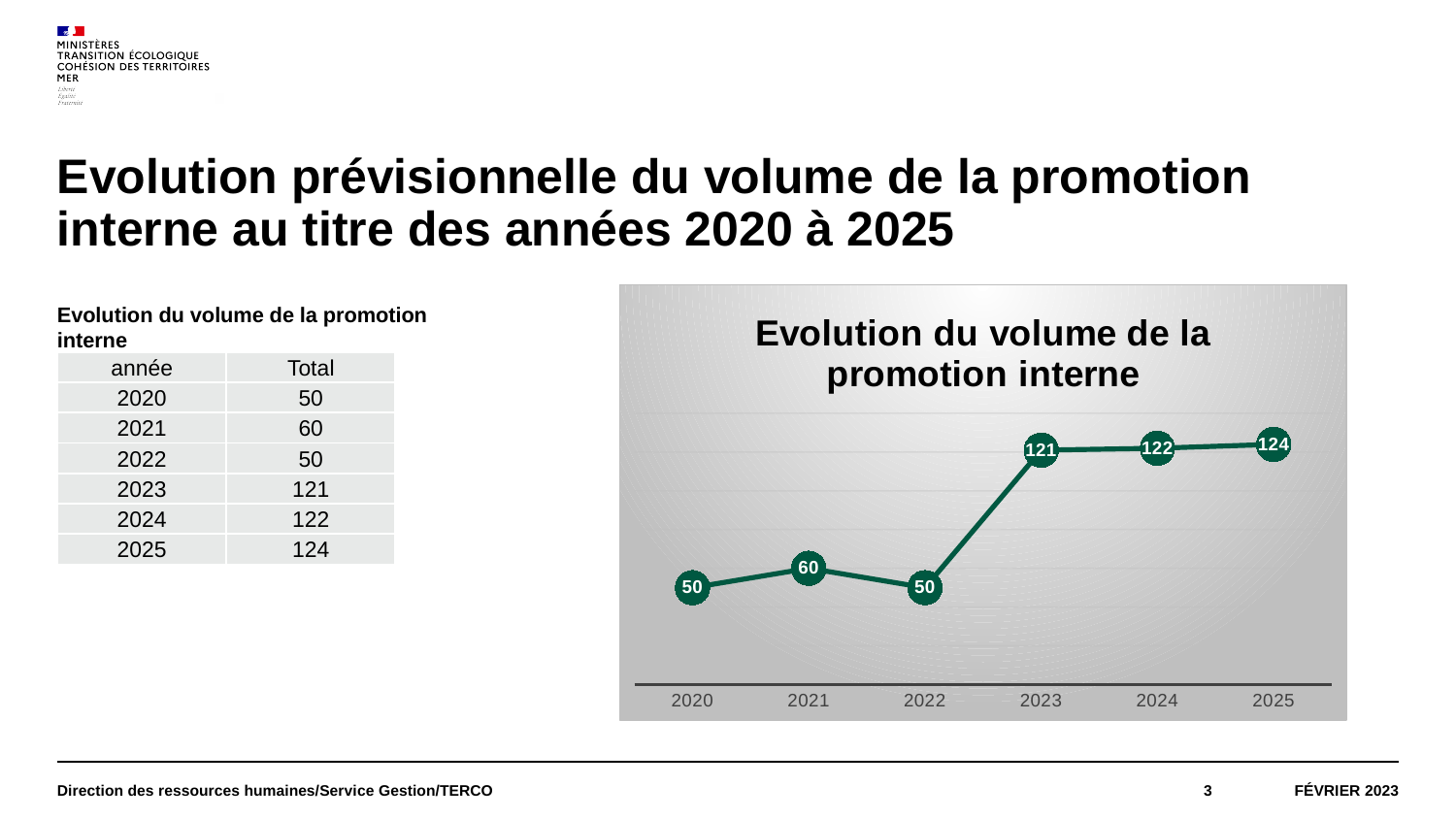
What is the difference between the values for 2023 and 2022? 71 What is the value for 2025 in the chart? 124 Which year has the highest value in the chart? 2025 What kind of chart is shown on the slide? line chart How many years are plotted in the chart? 6 What is the value for 2021 in the chart? 60 Which is larger, the value for 2021 or the value for 2022? 2021 Does the value rise or fall from 2022 to 2023? rise What is the difference between the values for 2025 and 2024? 2 What is the title of the chart? Evolution du volume de la promotion interne What is the value for 2020 in the chart? 50 What is the value for 2023 in the chart? 121